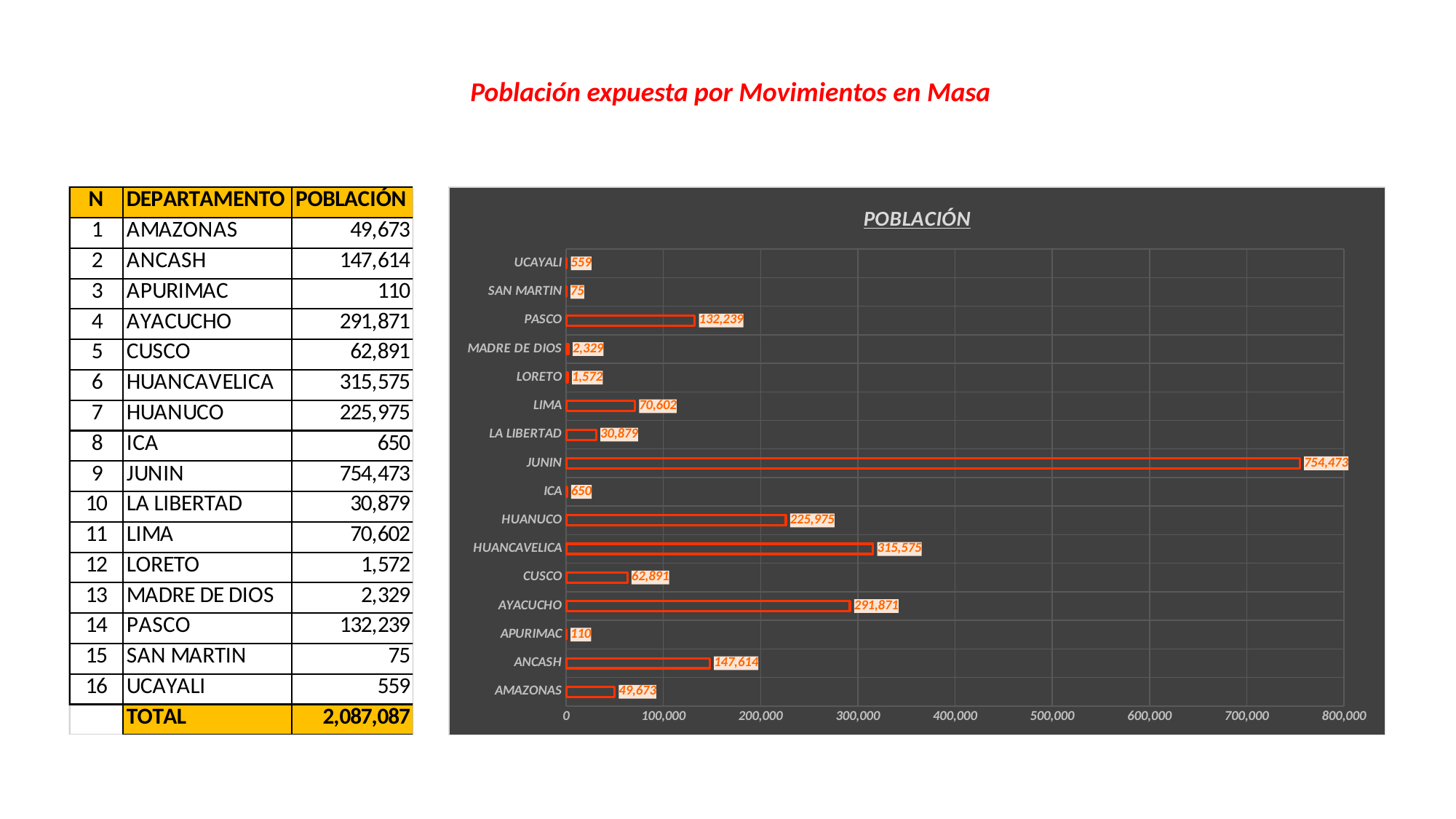
Which department has the lowest value in the POBLACIÓN chart? SAN MARTIN Which has a larger value in the POBLACIÓN chart, PASCO or LIMA? PASCO What is the difference between the values for AYACUCHO and ANCASH in the POBLACIÓN chart? 144,257 Which department has the highest value in the POBLACIÓN chart? JUNIN What is the value for JUNIN in the POBLACIÓN chart? 754,473 What kind of chart is the POBLACIÓN chart? bar chart How many departments are shown in the POBLACIÓN chart? 16 What is the value for MADRE DE DIOS in the POBLACIÓN chart? 2,329 What is the maximum value shown on the horizontal axis of the POBLACIÓN chart? 800,000 What is the value for HUANCAVELICA in the POBLACIÓN chart? 315,575 What is the title of the chart on the slide? POBLACIÓN Is the value for HUANUCO in the POBLACIÓN chart greater or less than 200,000? greater